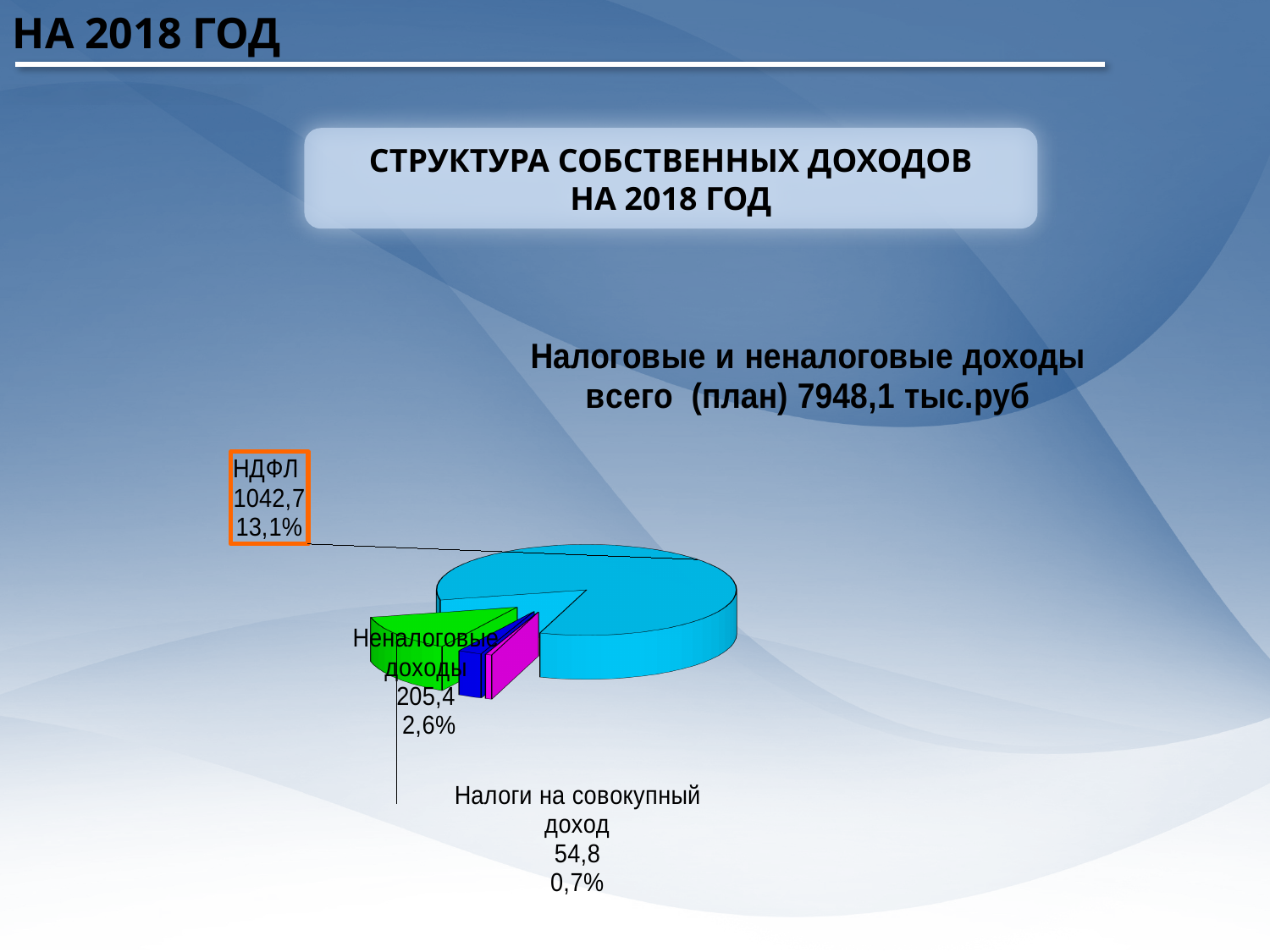
Which of the labelled slices has the smallest value? Налоги на совокупный доход Which is larger, the value for Неналоговые доходы or for Налоги на совокупный доход? Неналоговые доходы What share of the pie does НДФЛ represent? 13,1% What is the planned total of tax and non-tax revenues stated above the chart? 7948,1 тыс.руб Which of the labelled slices has the largest value? НДФЛ What is the value shown for Неналоговые доходы? 205,4 What kind of chart is shown on the slide? Pie chart What is the value shown for Налоги на совокупный доход? 54,8 What share of the pie do Налоги на совокупный доход represent? 0,7% What is the value shown for НДФЛ on the pie chart? 1042,7 What share of the pie do Неналоговые доходы represent? 2,6% What is the difference between the values for НДФЛ and Неналоговые доходы? 837,3